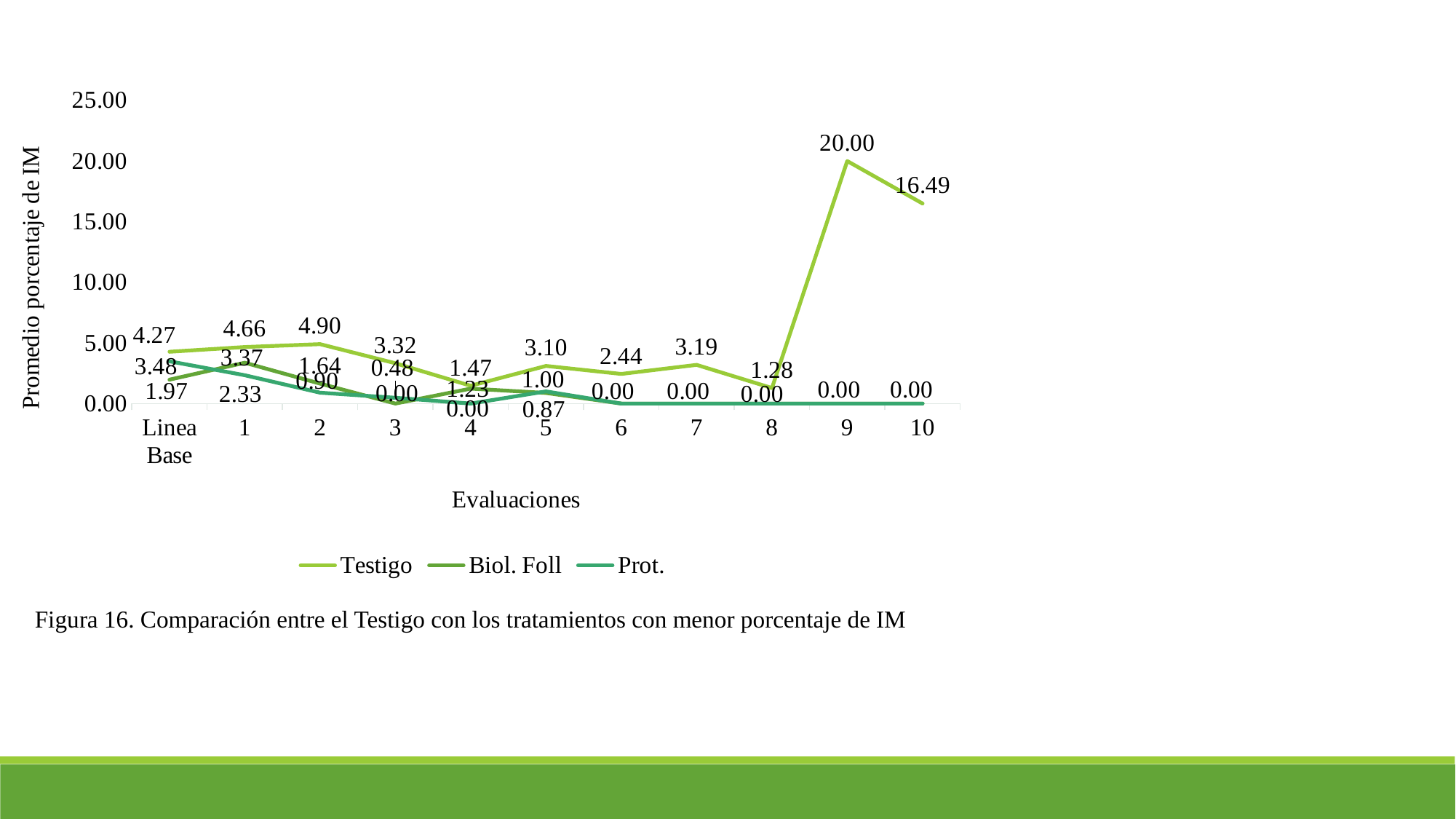
Is the Testigo value at evaluation 9 greater or less than 15.00? greater What is the value of the Testigo series at evaluation 9? 20.00 How many series does the legend list? 3 At which evaluation does the Testigo series reach its highest value? 9 What is the value of the Testigo series at Linea Base? 4.27 What is the value of the Testigo series at evaluation 10? 16.49 What is the difference between the Testigo values at evaluation 9 and evaluation 10? 3.51 How many evaluation points are shown on the x axis? 11 What is the title of the y axis? Promedio porcentaje de IM What kind of chart is shown on the slide? line chart At which evaluation does the Testigo series have its lowest value? 8 Which is larger for the Testigo series: the value at evaluation 2 or at evaluation 3? evaluation 2